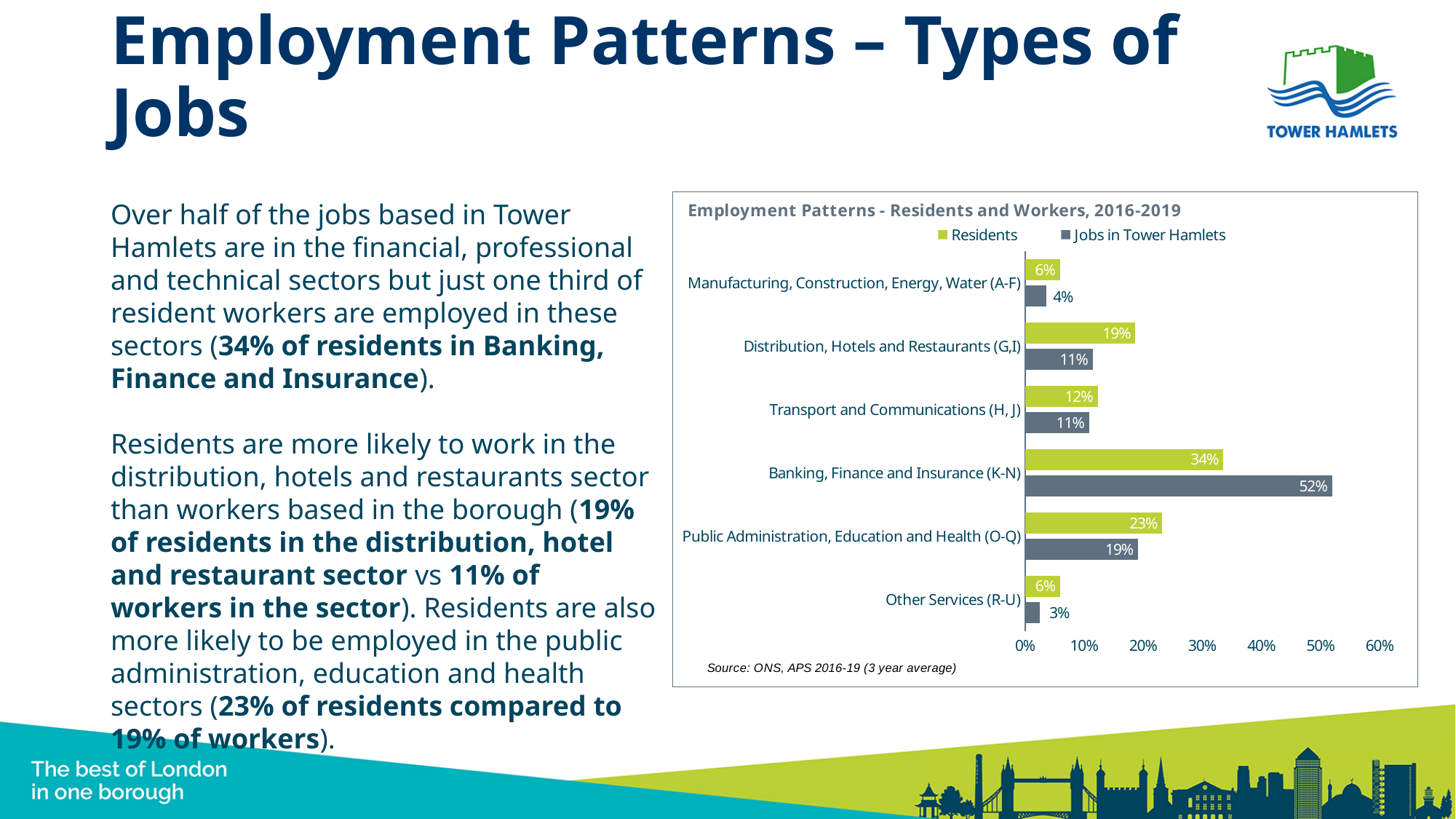
How many series does the legend list? 2 What is the Jobs in Tower Hamlets value for Other Services (R-U)? 3% Which category has the highest Jobs in Tower Hamlets value? Banking, Finance and Insurance (K-N) How many categories are shown on the chart? 6 Which is larger for Public Administration, Education and Health (O-Q): the Residents value or the Jobs in Tower Hamlets value? Residents What is the Jobs in Tower Hamlets value for Banking, Finance and Insurance (K-N)? 52% What is the difference between the Jobs in Tower Hamlets value and the Residents value for Banking, Finance and Insurance (K-N)? 18% What is the Residents value for Distribution, Hotels and Restaurants (G,I)? 19% Which category has the lowest Jobs in Tower Hamlets value? Other Services (R-U) What kind of chart is shown on the slide? Bar chart What is the Residents value for Banking, Finance and Insurance (K-N)? 34% What is the title of the chart? Employment Patterns - Residents and Workers, 2016-2019